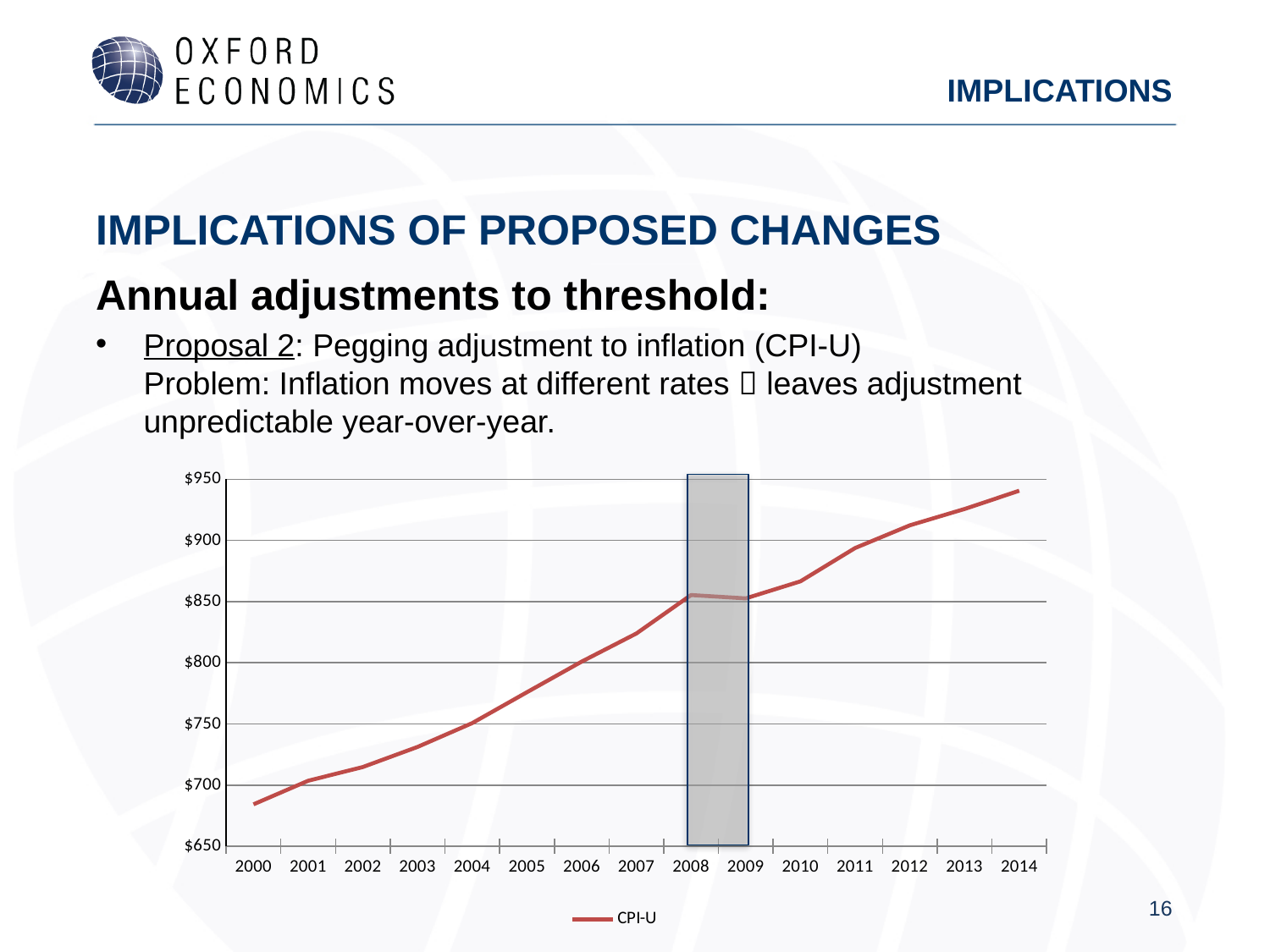
Is the CPI-U value for 2000 greater or less than $700? less Is the CPI-U value for 2010 greater or less than $850? greater Which year has the larger CPI-U value, 2005 or 2011? 2011 How many series does the legend list? 1 Is the CPI-U value for 2014 greater or less than $900? greater How many years are plotted along the x axis? 15 What is the name of the series shown in the legend? CPI-U Do the CPI-U values generally rise or fall from 2000 to 2014? rise Which year has the highest CPI-U value? 2014 What kind of chart is shown on the slide? line chart Which year has the lowest CPI-U value? 2000